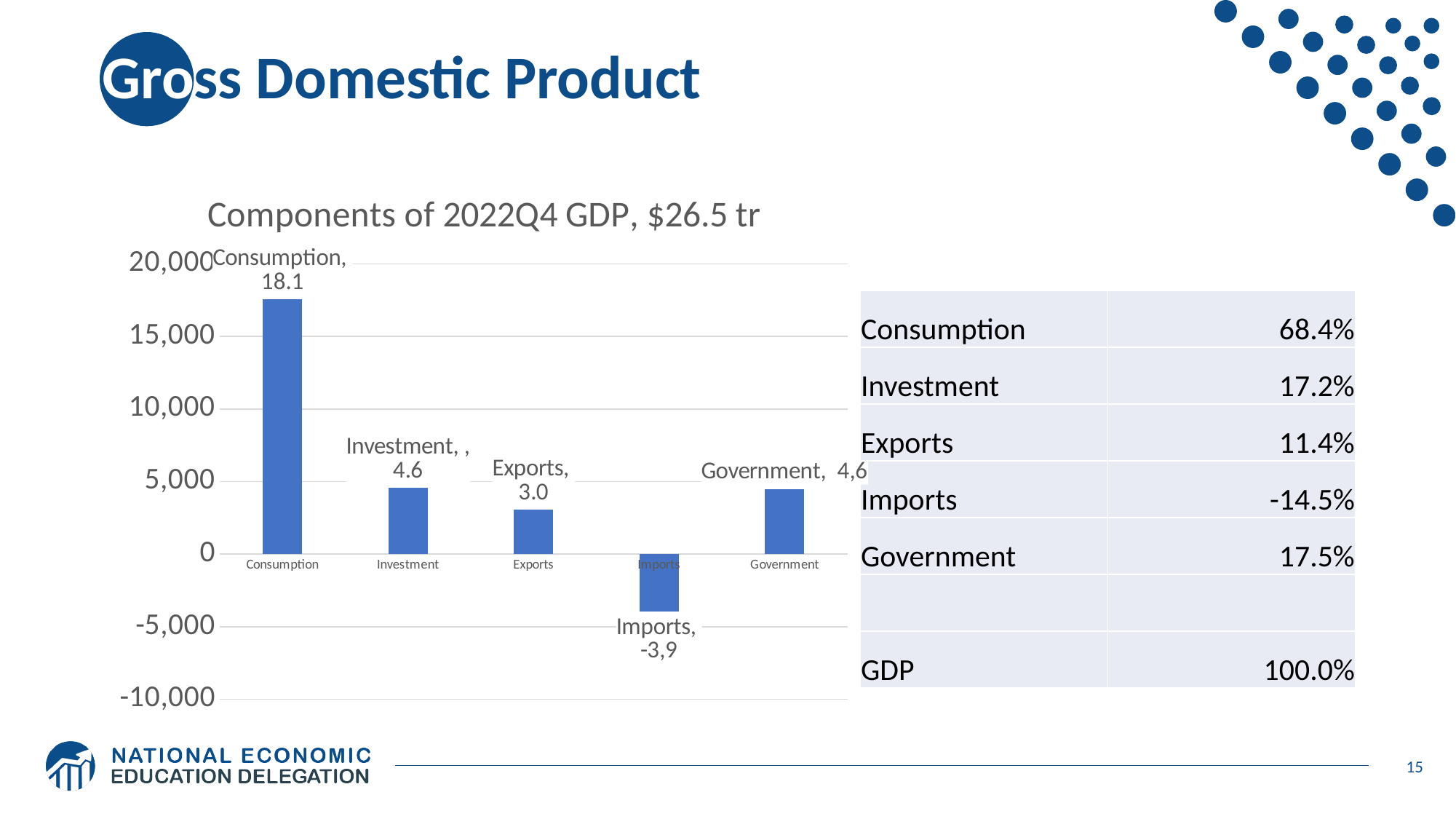
Which is larger in the chart, Investment or Exports? Investment What is the data label value for Investment in the chart? 4.6 Which category has the highest bar in the chart? Consumption What is the data label value for Exports in the chart? 3.0 What is the data label value for Consumption in the chart? 18.1 What is the data label value for Imports in the chart? -3,9 Is the Consumption bar greater or less than 15,000 on the axis? greater Which category has the lowest bar in the chart? Imports What is the title of the chart? Components of 2022Q4 GDP, $26.5 tr How many categories are plotted in the chart? 5 What is the difference between the Consumption and Exports data labels? 15.1 What kind of chart is shown on the slide? bar chart